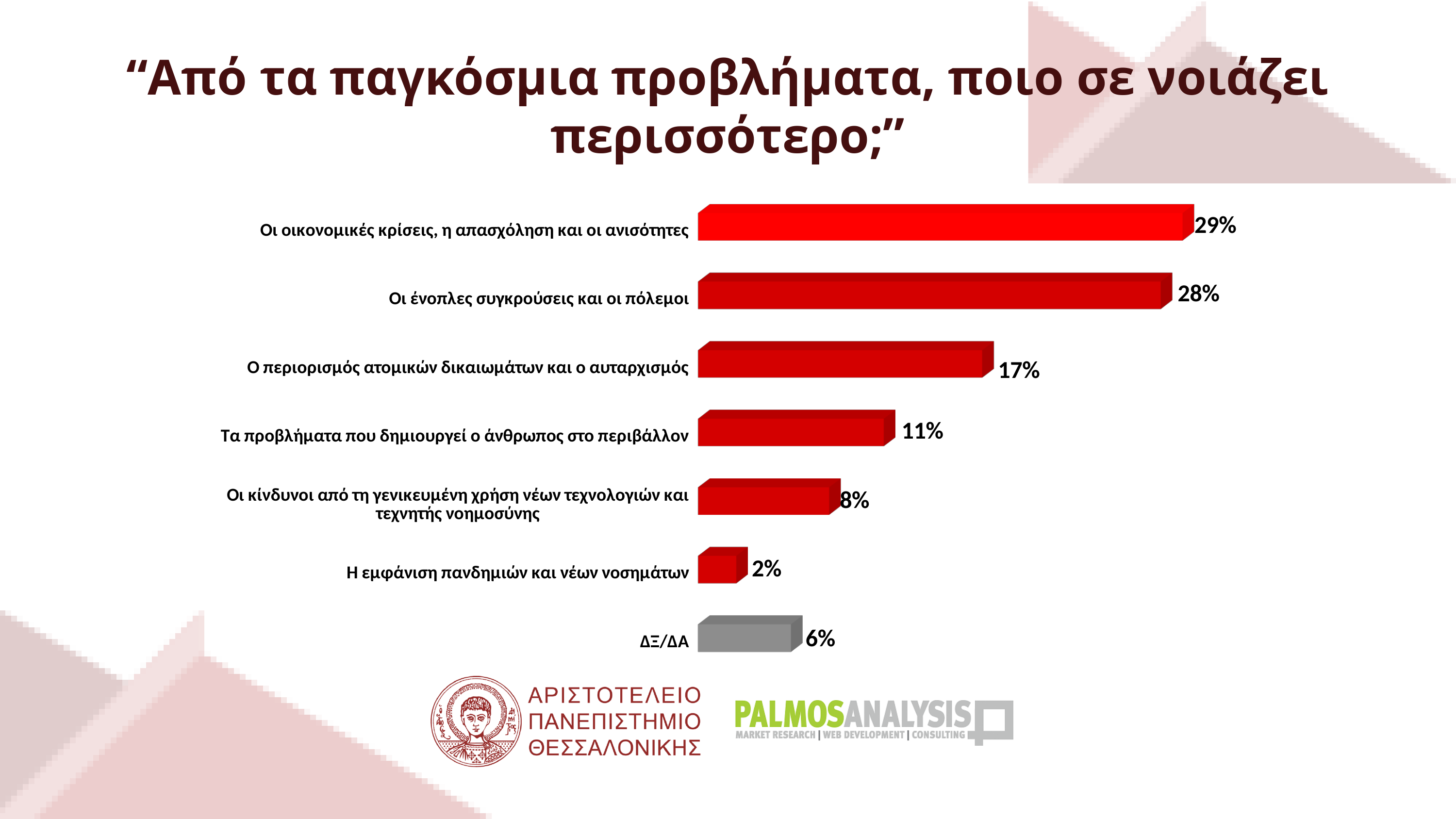
What is the difference between the values for "Οι ένοπλες συγκρούσεις και οι πόλεμοι" and "Ο περιορισμός ατομικών δικαιωμάτων και ο αυταρχισμός"? 11% What value is shown for "Ο περιορισμός ατομικών δικαιωμάτων και ο αυταρχισμός"? 17% What percentage is shown for "Τα προβλήματα που δημιουργεί ο άνθρωπος στο περιβάλλον"? 11% How many categories are shown in the chart? 7 What type of chart is shown on the slide? Bar chart What percentage of respondents chose "Οι οικονομικές κρίσεις, η απασχόληση και οι ανισότητες"? 29% What percentage is shown for ΔΞ/ΔΑ? 6% Which category has the lowest value in the chart? Η εμφάνιση πανδημιών και νέων νοσημάτων Which is larger: the value for "Οι κίνδυνοι από τη γενικευμένη χρήση νέων τεχνολογιών και τεχνητής νοημοσύνης" or the value for ΔΞ/ΔΑ? Οι κίνδυνοι από τη γενικευμένη χρήση νέων τεχνολογιών και τεχνητής νοημοσύνης What is the value for "Η εμφάνιση πανδημιών και νέων νοσημάτων"? 2% What is the value shown for "Οι ένοπλες συγκρούσεις και οι πόλεμοι"? 28% Which category has the highest value in the chart? Οι οικονομικές κρίσεις, η απασχόληση και οι ανισότητες